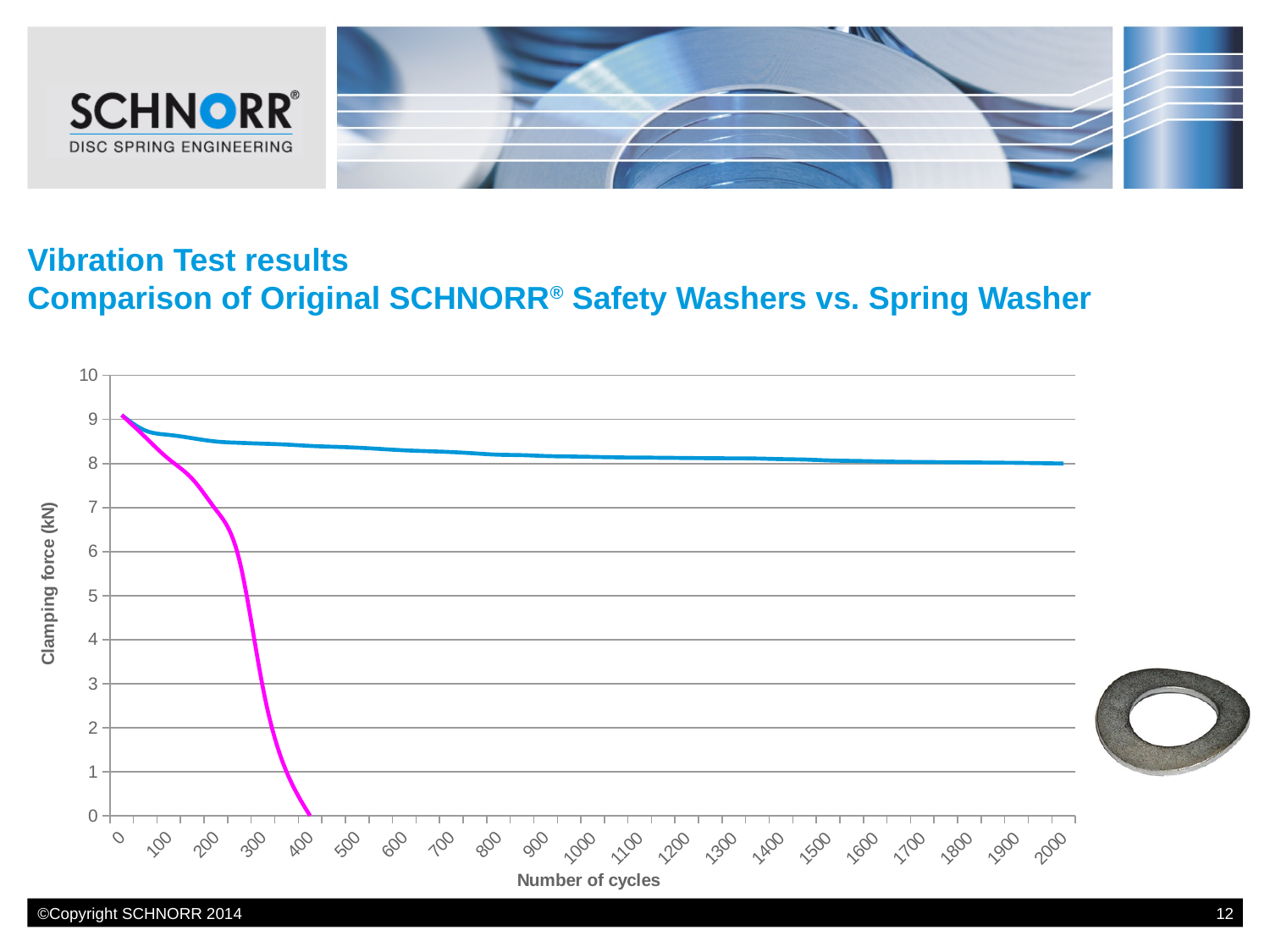
Which line drops to a clamping force of 0 before 500 cycles? magenta line What is the largest number of cycles labelled on the x-axis? 2000 Does the blue line rise or fall as the number of cycles increases? fall At 200 cycles, which line shows the higher clamping force, the blue line or the magenta line? blue line What kind of chart is shown on the slide? line chart How many lines are plotted on the chart? 2 What is the highest value shown on the y-axis? 10 What is the title of the x-axis of the chart? Number of cycles Does the magenta line rise or fall as the number of cycles increases? fall Is the clamping force of the blue line at 2000 cycles greater or less than 7? greater What is the title of the y-axis of the chart? Clamping force (kN) Is the clamping force of the magenta line at 300 cycles greater or less than 6? less